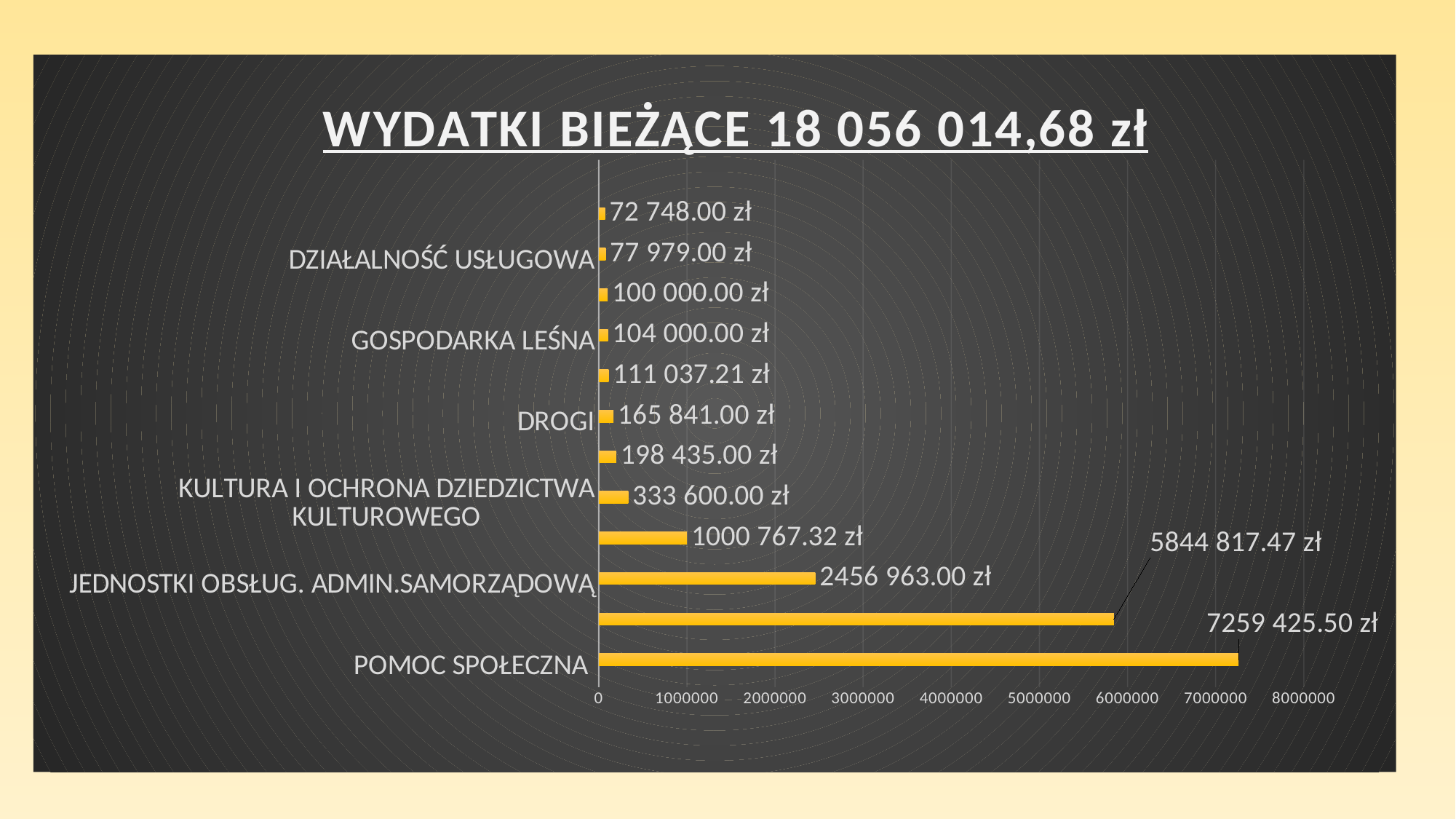
Is the value for POMOC SPOŁECZNA greater or less than 7000000? greater How many bars are plotted on the chart? 12 What is the difference between the values for POMOC SPOŁECZNA and JEDNOSTKI OBSŁUG. ADMIN.SAMORZĄDOWĄ? 4802 462.50 zł Which labelled category has the highest value? POMOC SPOŁECZNA What is the smallest value shown on the chart? 72 748.00 zł What is the value for KULTURA I OCHRONA DZIEDZICTWA KULTUROWEGO? 333 600.00 zł What is the value for POMOC SPOŁECZNA? 7259 425.50 zł What is the title of the chart? WYDATKI BIEŻĄCE 18 056 014,68 zł What is the value for DROGI? 165 841.00 zł What is the value for GOSPODARKA LEŚNA? 104 000.00 zł Which is larger, the value for DROGI or the value for GOSPODARKA LEŚNA? DROGI What is the value for JEDNOSTKI OBSŁUG. ADMIN.SAMORZĄDOWĄ? 2456 963.00 zł